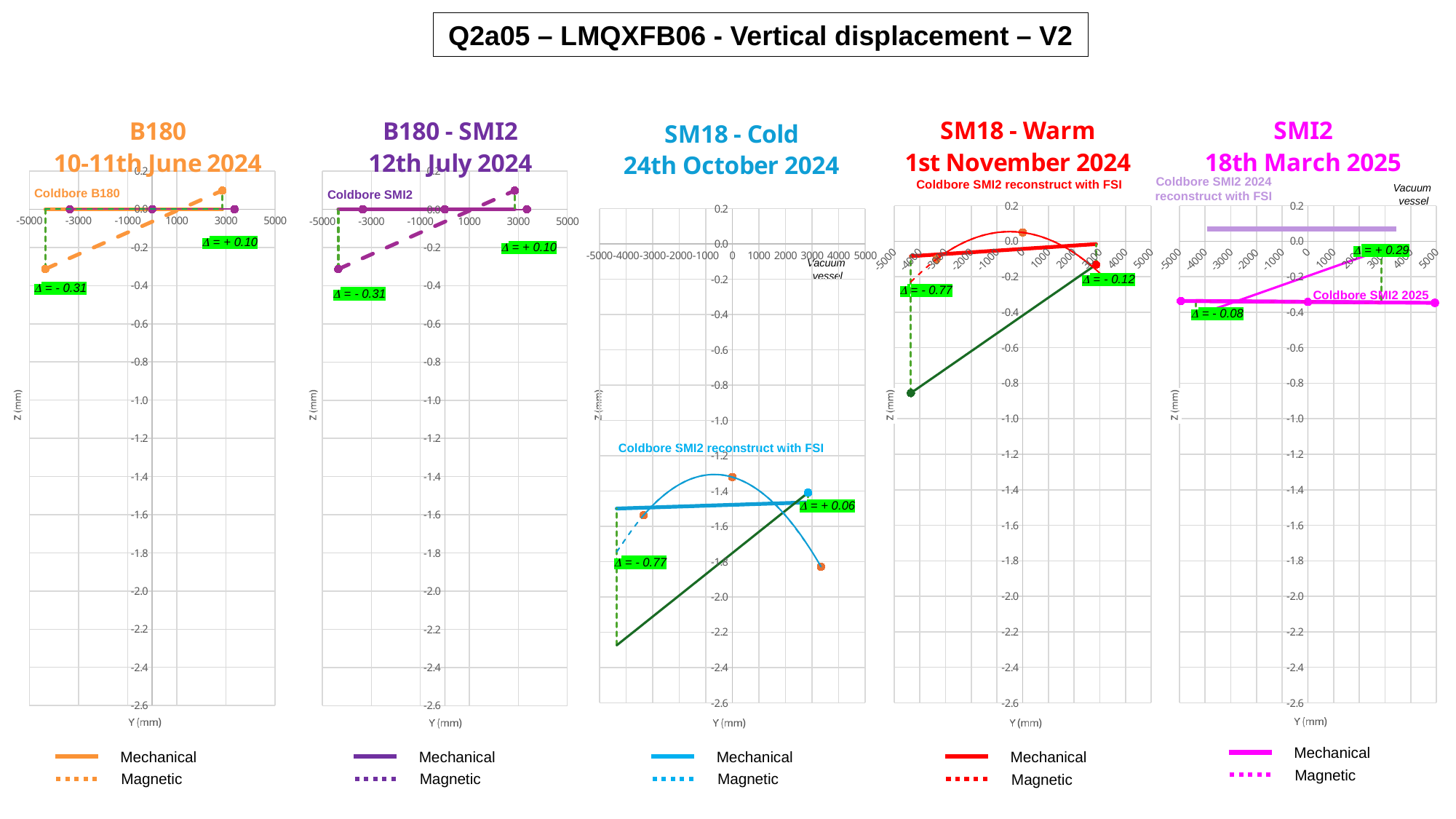
In the SM18 - Cold 24th October 2024 chart, what is the Δ value shown on the right side? + 0.06 How many series does the legend of the B180 - SMI2 12th July 2024 chart list? 2 How many charts are shown on the slide? 5 In the SM18 - Cold 24th October 2024 chart, which Δ value is larger, the left one or the right one? the right one (+ 0.06) In the B180 10-11th June 2024 chart, what is the Δ value shown on the right side? + 0.10 In the SM18 - Cold 24th October 2024 chart, what is the Δ value shown on the left side? - 0.77 What is the label of the vertical axis on the B180 10-11th June 2024 chart? Z (mm) In the SMI2 18th March 2025 chart, what is the Δ value shown on the left side? - 0.08 In the SMI2 18th March 2025 chart, what is the Δ value shown on the right side? + 0.29 In the SM18 - Warm 1st November 2024 chart, what is the Δ value shown on the right side? - 0.12 In the B180 10-11th June 2024 chart, what is the Δ value shown on the left side? - 0.31 What kind of chart is the SM18 - Warm 1st November 2024 chart? line chart